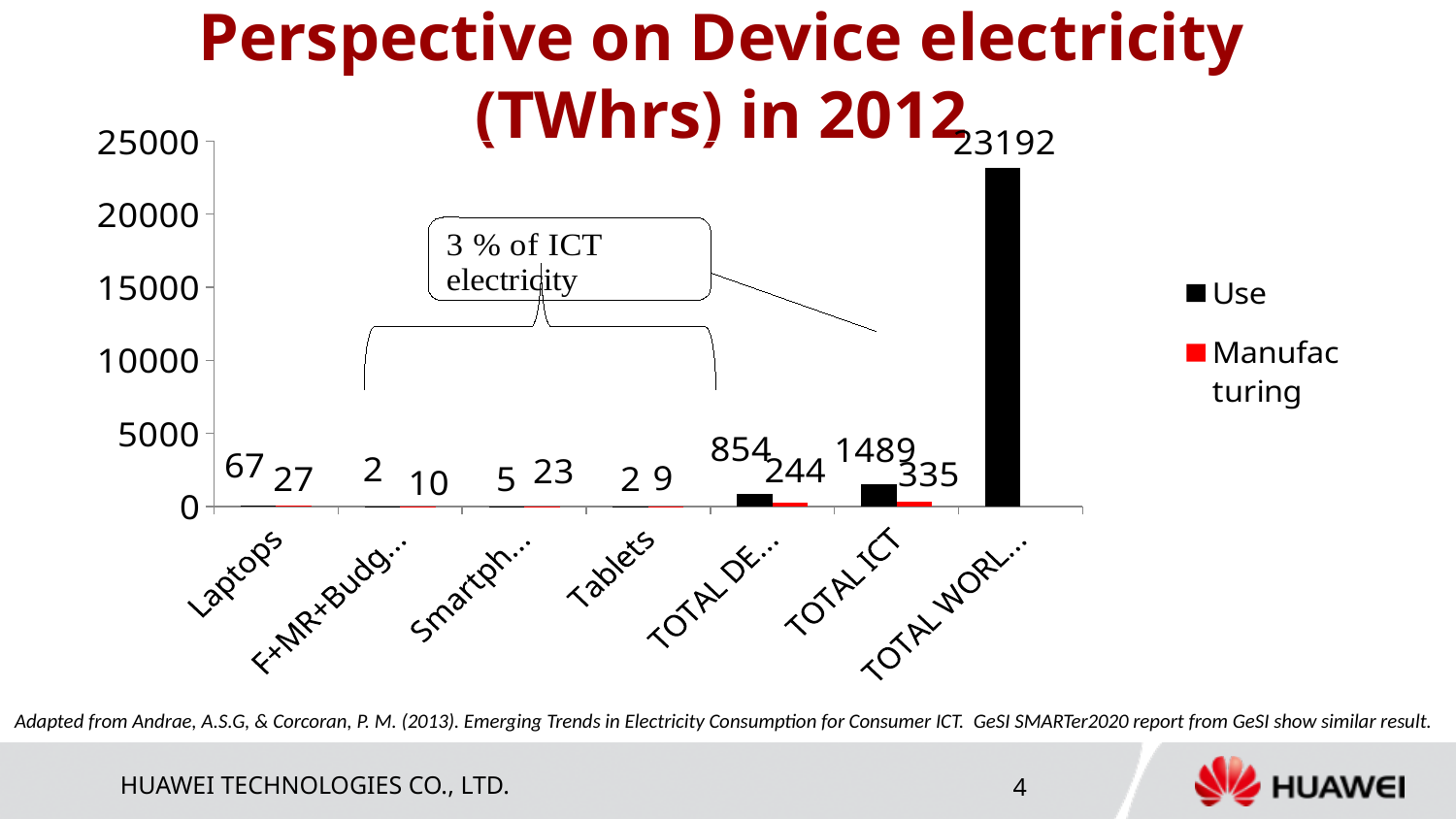
What is the difference between the Use and Manufacturing values for TOTAL ICT? 1154 What is the Use value for Laptops? 67 What is the Use value for Tablets? 2 Which is larger for Tablets, the Use value or the Manufacturing value? Manufacturing What is the Use value for the rightmost category on the chart? 23192 What type of chart is shown on the slide? bar chart What is the Manufacturing value for Laptops? 27 How many series does the legend list? 2 What is the Use value for TOTAL ICT? 1489 Which colour represents the Use series in the legend? black What is the Manufacturing value for TOTAL ICT? 335 How many categories are shown on the x axis? 7